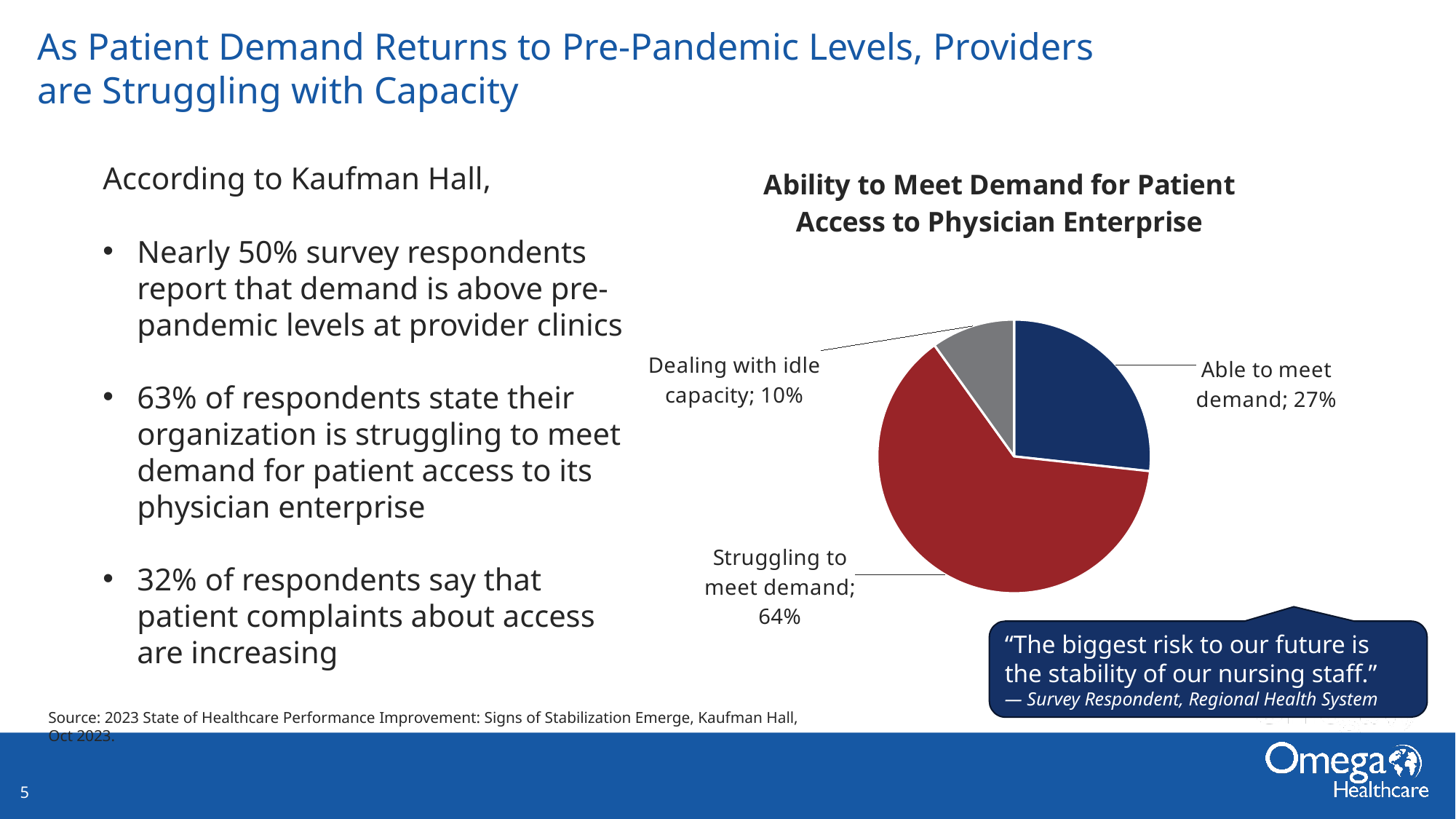
Which is larger: the share for 'Able to meet demand' or for 'Dealing with idle capacity'? Able to meet demand What is the difference in percentage points between 'Struggling to meet demand' and 'Able to meet demand'? 37 Which category has the smallest slice of the pie? Dealing with idle capacity What is the title of the chart? Ability to Meet Demand for Patient Access to Physician Enterprise What colour is the 'Struggling to meet demand' slice? Red What is the difference in percentage points between 'Able to meet demand' and 'Dealing with idle capacity'? 17 What kind of chart is shown on the slide? Pie chart Which category has the largest slice of the pie? Struggling to meet demand What share of respondents are dealing with idle capacity? 10% How many slices does the pie chart have? 3 What share of respondents are struggling to meet demand? 64% What share of respondents are able to meet demand? 27%